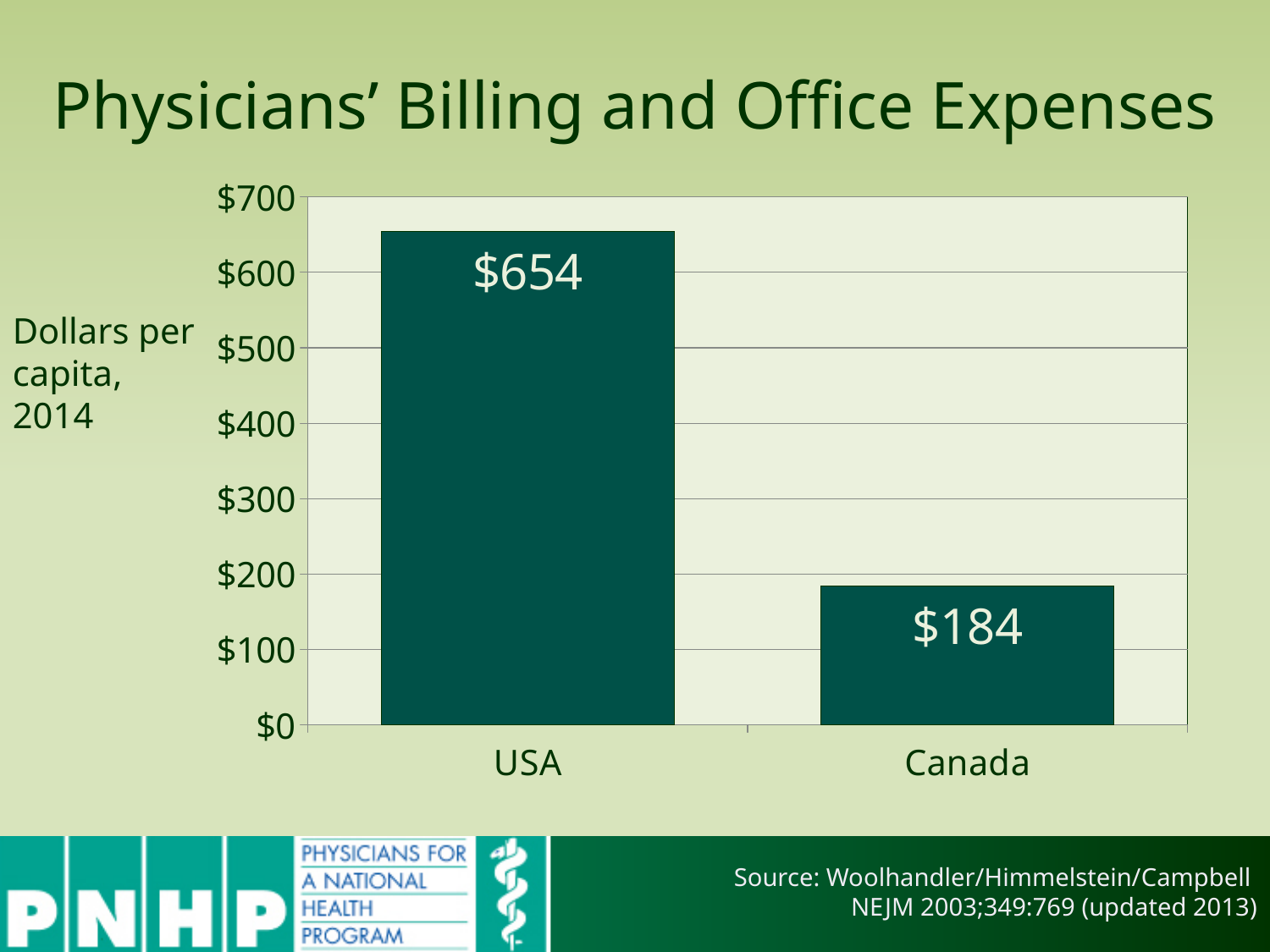
How many categories are shown in the chart? 2 What is the difference between the values for USA and Canada? $470 Is the value for USA greater or less than $600? greater What unit does the y-axis label describe? Dollars per capita, 2014 Which is larger, the value for USA or the value for Canada? USA Is the value for Canada greater or less than $200? less Which category has the highest value? USA Which category has the lowest value? Canada What is the title of the chart? Physicians' Billing and Office Expenses What is the value for Canada? $184 What is the value for USA? $654 What kind of chart is shown on the slide? bar chart